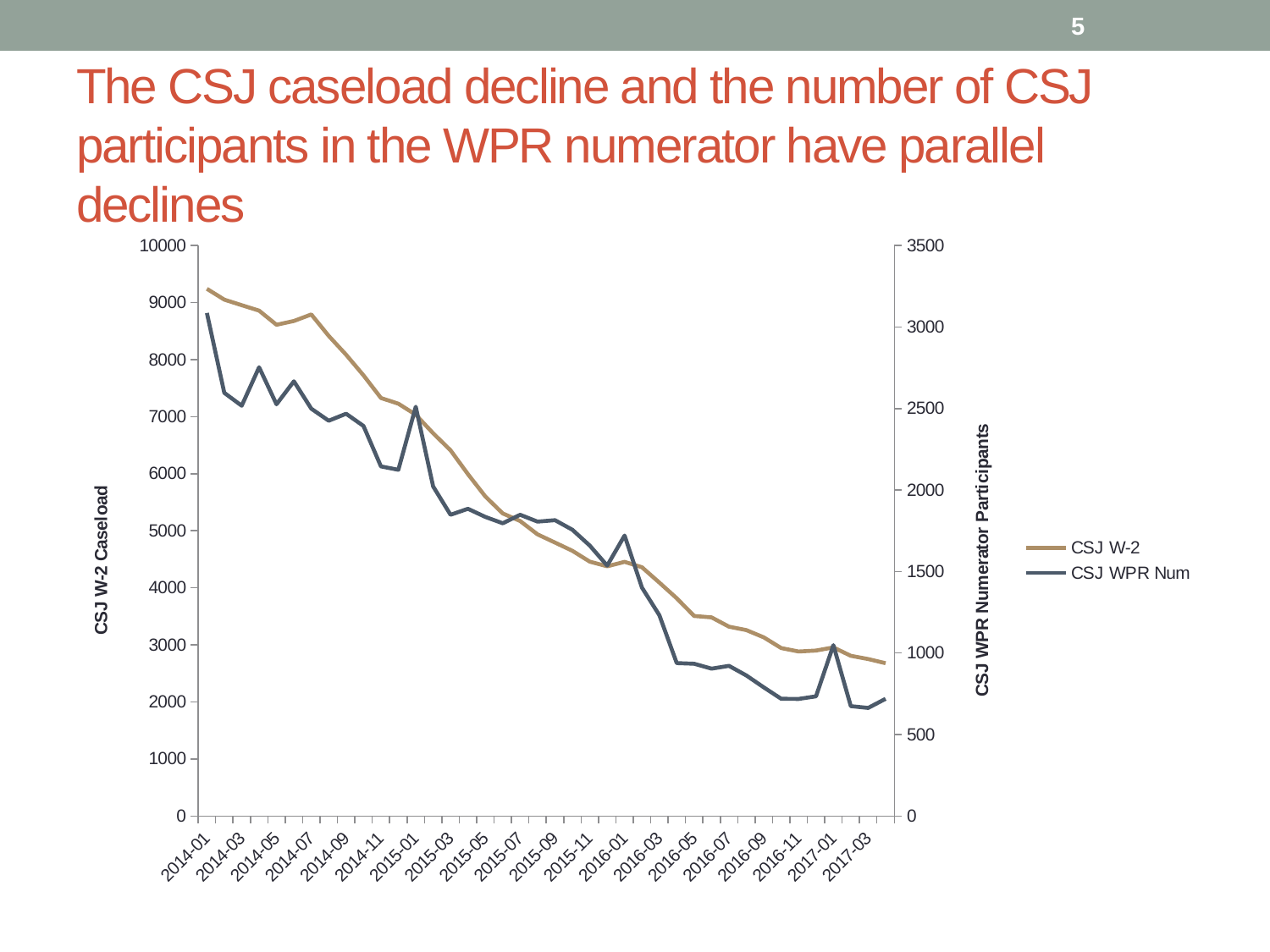
What is the title of the left vertical axis? CSJ W-2 Caseload Do the CSJ W-2 values rise or fall from 2014-01 to 2017-03? Fall How many series does the legend list? 2 Is the CSJ W-2 value for 2014-01 greater or less than 8000? greater Is the CSJ WPR Num value for 2014-01 greater or less than 2500? greater What kind of chart is shown on the slide? Line chart Is the CSJ WPR Num value for 2017-03 greater or less than 1000? less At which month is the CSJ W-2 series highest? 2014-01 Do the CSJ WPR Num values rise or fall over the period shown? Fall What are the two series named in the legend? CSJ W-2 and CSJ WPR Num At which month is the CSJ WPR Num series highest? 2014-01